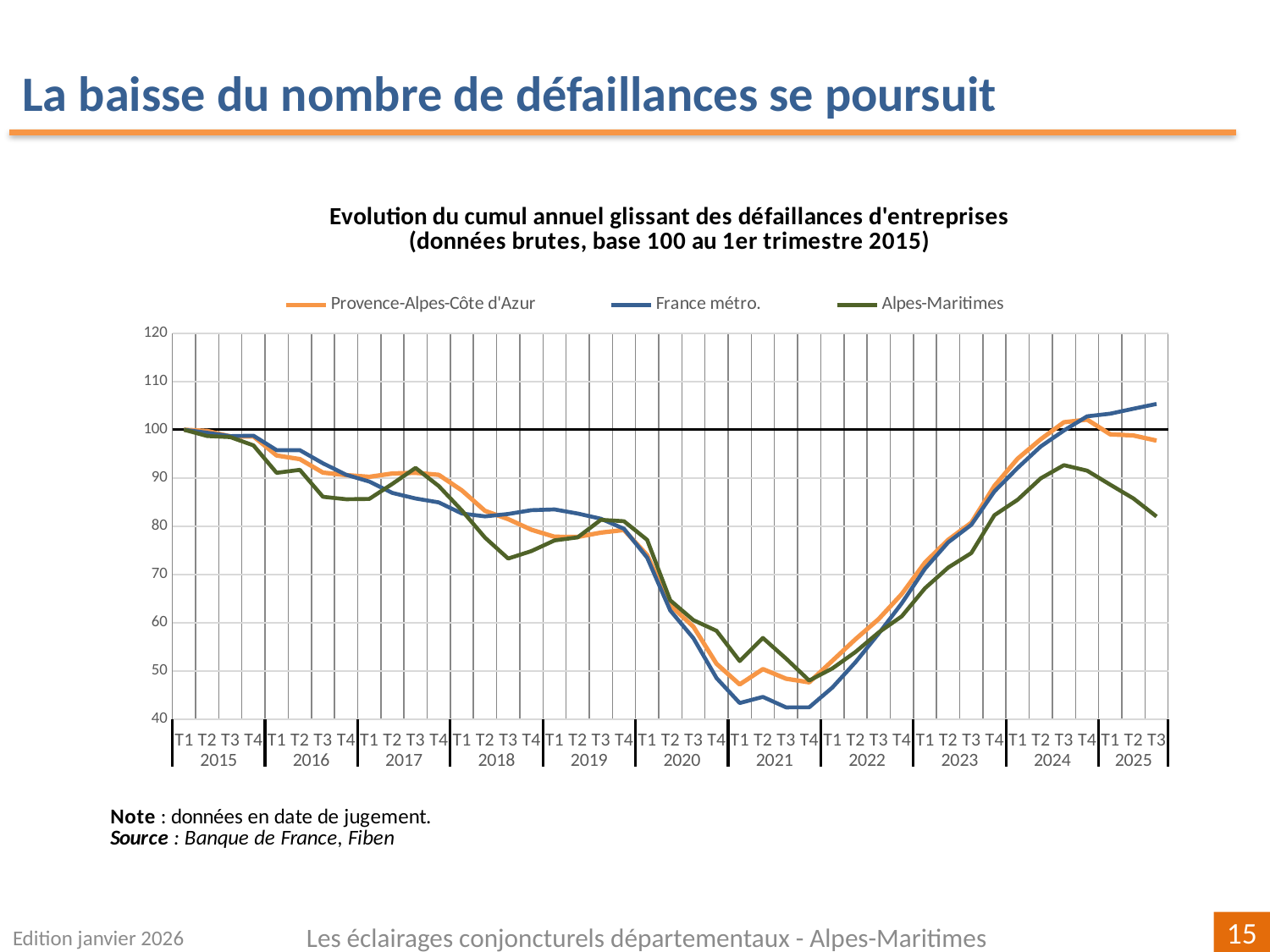
How many series does the legend list? 3 Which series has the lowest value at T3 2021? France métro. What kind of chart is shown on the slide? line chart Does the Provence-Alpes-Côte d'Azur series rise or fall between T1 2022 and T3 2024? rise Does the France métro. series rise or fall between T1 2015 and T1 2021? fall Is the value for Alpes-Maritimes at T3 2018 greater or less than 80? less Which series is drawn in orange in the legend? Provence-Alpes-Côte d'Azur Is the value for France métro. at T3 2025 greater or less than 100? greater What is the value of the France métro. series at T1 2015? 100 Which series has the highest value at T3 2025? France métro. Is the value for Alpes-Maritimes at T3 2025 greater or less than 90? less